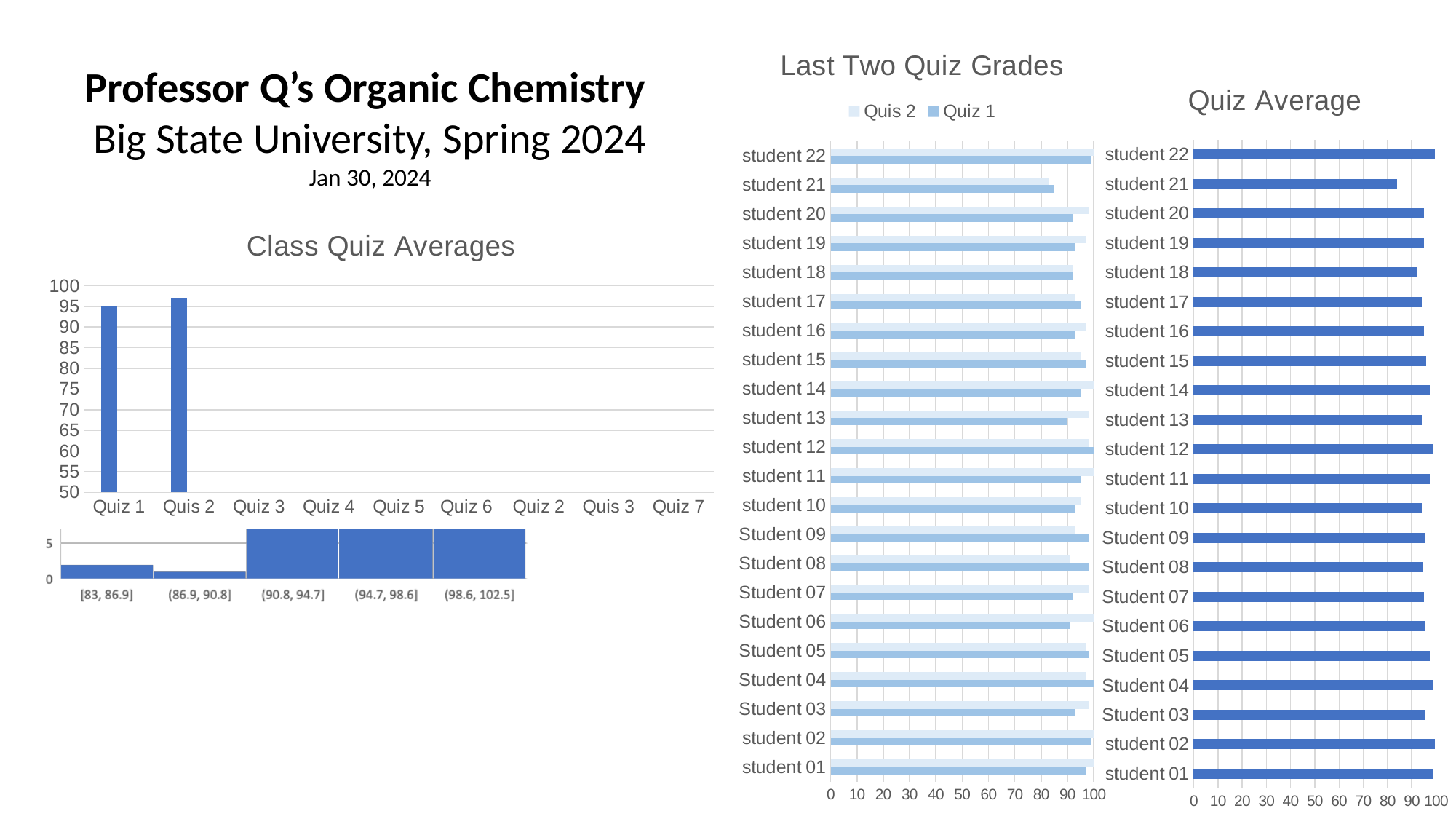
In the 'Class Quiz Averages' chart, which is higher, Quiz 1 or Quis 2? Quis 2 In the untitled histogram below the 'Class Quiz Averages' chart, how many bins are shown on the x axis? 5 How many series does the legend of the 'Last Two Quiz Grades' chart list? 2 What kind of chart is the 'Class Quiz Averages' chart? bar chart In the 'Last Two Quiz Grades' chart, is the Quiz 1 value for student 21 greater or less than 90? less What are the legend entries of the 'Last Two Quiz Grades' chart? Quis 2 and Quiz 1 In the 'Class Quiz Averages' chart, is the value for Quis 2 greater or less than 95? greater In the 'Class Quiz Averages' chart, what is the value for Quiz 1? 95 How many students are shown in the 'Quiz Average' chart? 22 In the 'Quiz Average' chart, is the value for student 22 greater or less than 90? greater In the 'Class Quiz Averages' chart, how many categories are shown on the x axis? 9 In the 'Quiz Average' chart, which student has the lowest average? student 21